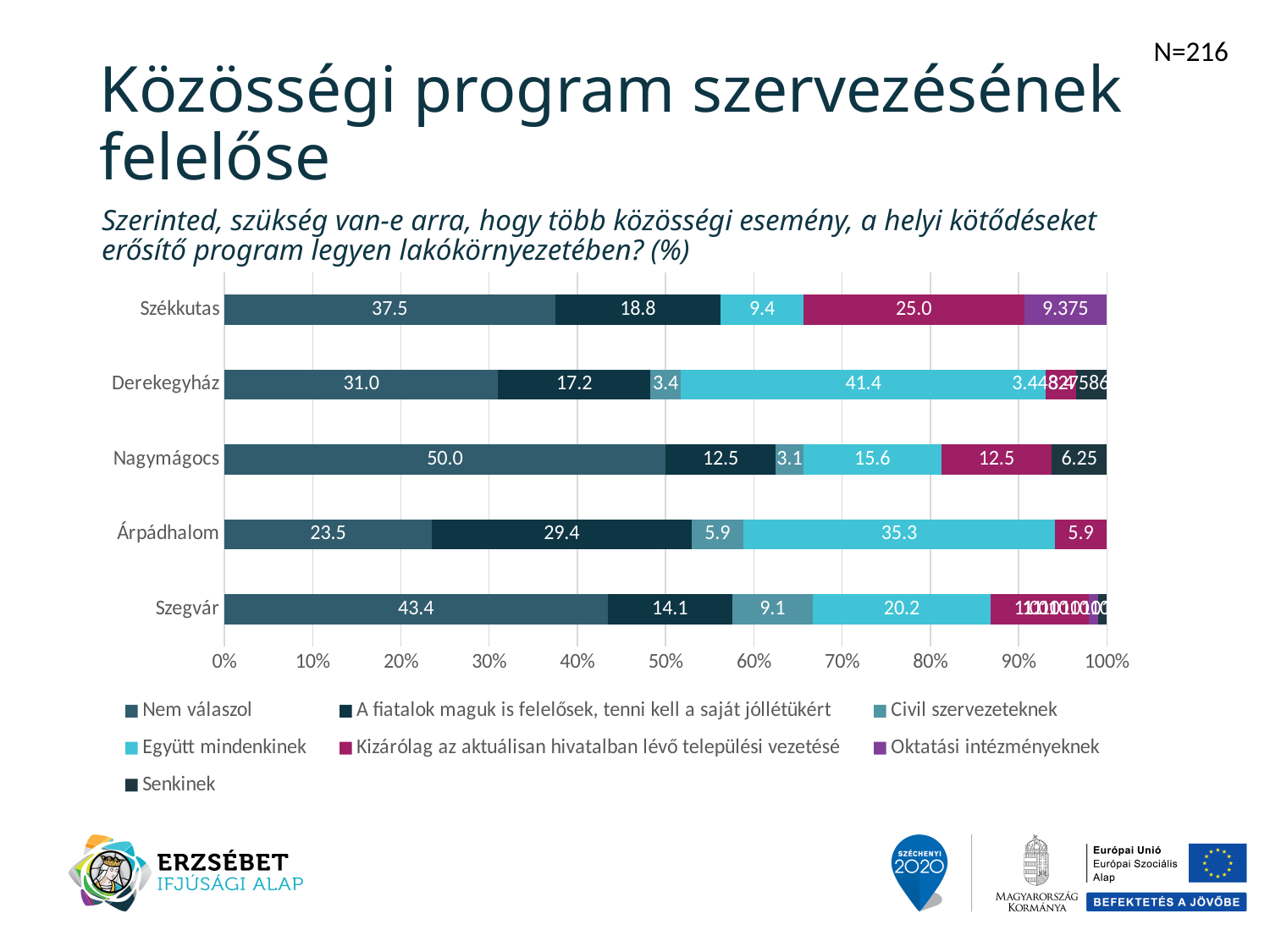
How many series does the legend list? 7 What is the value of 'Kizárólag az aktuálisan hivatalban lévő települési vezetésé' for Nagymágocs? 12.5 Which settlement has the lowest 'Nem válaszol' value? Árpádhalom What kind of chart is shown on the slide? Stacked bar chart How many settlements (categories) are shown on the chart? 5 Which has the larger value for 'A fiatalok maguk is felelősek, tenni kell a saját jóllétükért': Árpádhalom or Derekegyház? Árpádhalom What sample size (N) is indicated on the slide? N=216 What is the value of 'Együtt mindenkinek' for Derekegyház? 41.4 What is the value of 'Nem válaszol' for Nagymágocs? 50.0 What is the value of 'Kizárólag az aktuálisan hivatalban lévő települési vezetésé' for Székkutas? 25.0 Which settlement has the highest 'Nem válaszol' value? Nagymágocs What is the difference between the 'Nem válaszol' values for Szegvár and Székkutas? 5.9